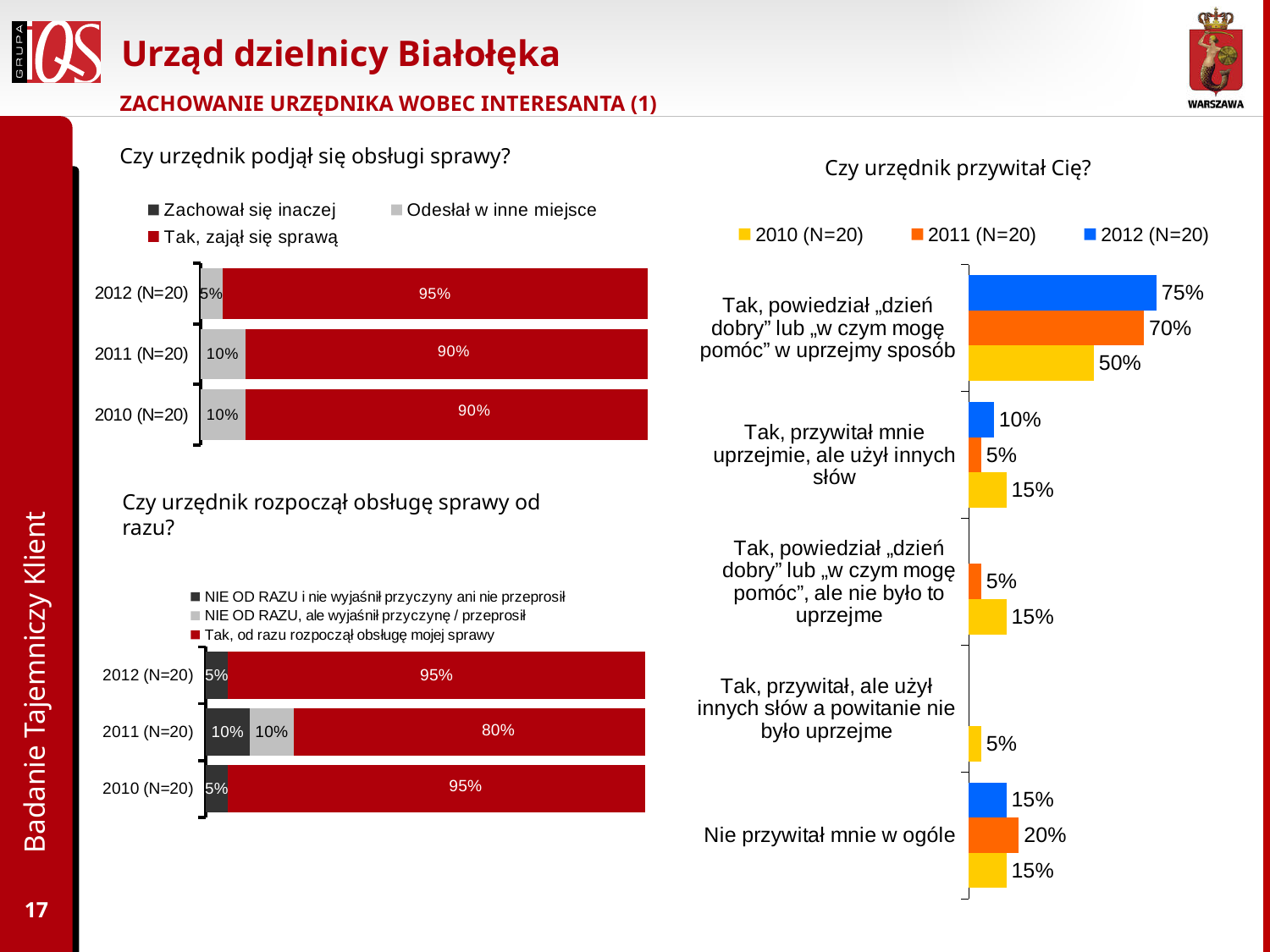
What kind of chart is "Czy urzędnik rozpoczął obsługę sprawy od razu?"? Stacked bar chart In the chart "Czy urzędnik przywitał Cię?", what is the value for 2011 (N=20) in the category "Nie przywitał mnie w ogóle"? 20% In the chart "Czy urzędnik przywitał Cię?", how many categories are shown? 5 In the chart "Czy urzędnik przywitał Cię?", how many series does the legend list? 3 In the chart "Czy urzędnik rozpoczął obsługę sprawy od razu?", what is the value of "Tak, od razu rozpoczął obsługę mojej sprawy" for 2011 (N=20)? 80% In the chart "Czy urzędnik przywitał Cię?", what is the value for 2010 (N=20) in the category "Tak, powiedział „dzień dobry” lub „w czym mogę pomóc” w uprzejmy sposób"? 50% In the chart "Czy urzędnik przywitał Cię?", which year has the highest value for "Tak, powiedział „dzień dobry” lub „w czym mogę pomóc” w uprzejmy sposób"? 2012 (N=20) In the chart "Czy urzędnik podjął się obsługi sprawy?", what is the value of "Odesłał w inne miejsce" for 2011 (N=20)? 10% In the chart "Czy urzędnik podjął się obsługi sprawy?", what is the value of "Tak, zajął się sprawą" for 2012 (N=20)? 95% In the chart "Czy urzędnik przywitał Cię?", what is the difference between the 2012 and 2010 values for "Tak, powiedział „dzień dobry” lub „w czym mogę pomóc” w uprzejmy sposób"? 25% In the chart "Czy urzędnik rozpoczął obsługę sprawy od razu?", which year has the lowest value for "Tak, od razu rozpoczął obsługę mojej sprawy"? 2011 (N=20) In the chart "Czy urzędnik przywitał Cię?", what is the value for 2012 (N=20) in the category "Tak, powiedział „dzień dobry” lub „w czym mogę pomóc” w uprzejmy sposób"? 75%